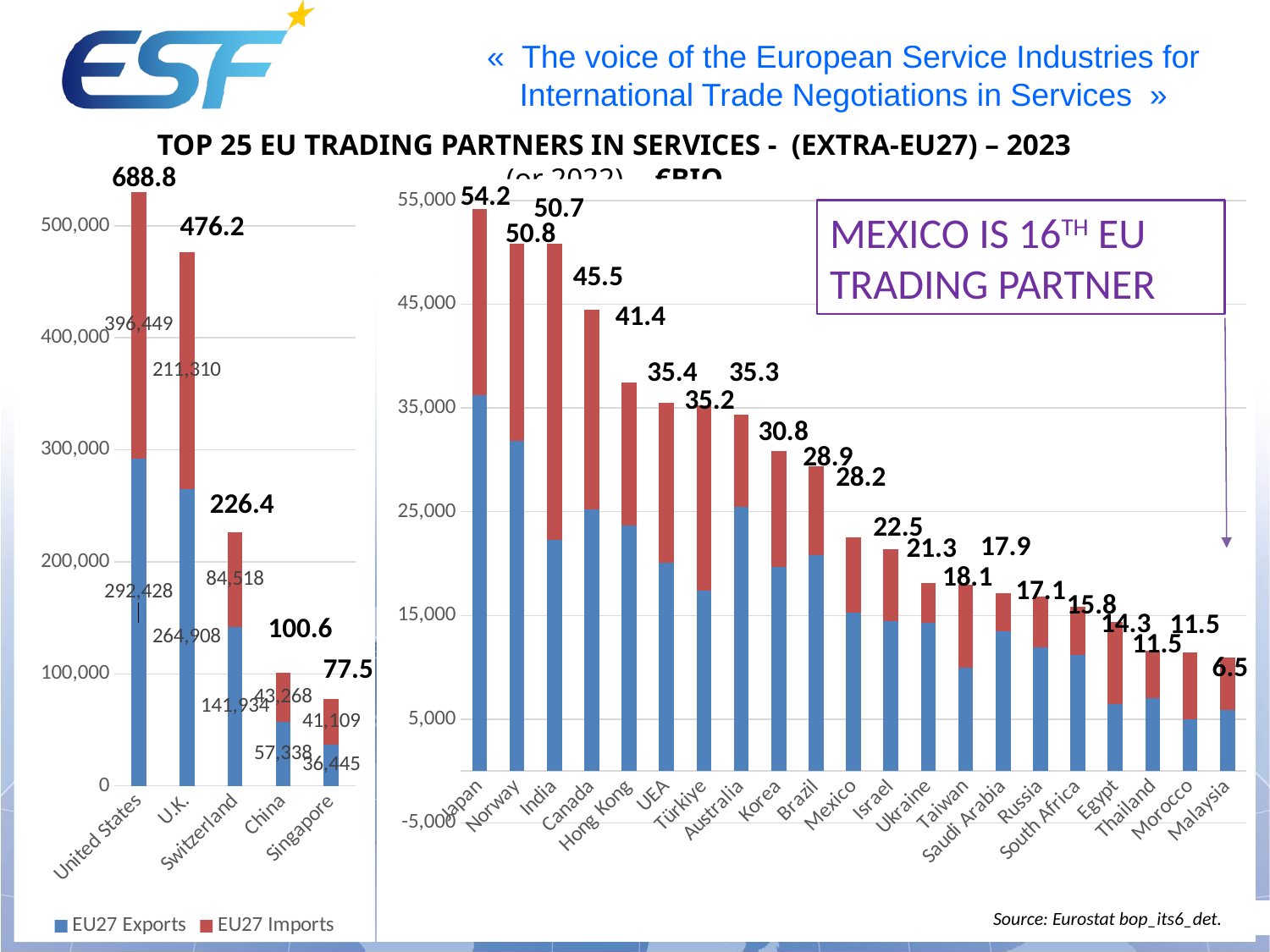
On the right chart, which trading partner has the lowest total? Malaysia According to the text box on the slide, what rank is Mexico among EU trading partners? 16th On the left chart, what is the total value labelled above the United States bar? 688.8 On the left chart, what is the total value labelled above the Singapore bar? 77.5 On the left chart, what is the EU27 Exports value for the United Kingdom? 264,908 On the left chart, for the U.K., which is larger: EU27 Exports or EU27 Imports? EU27 Exports On the left chart, what is the EU27 Imports value for the United States? 396,449 What kind of chart is the right chart? Stacked bar chart On the right chart, is the value for Japan greater or less than 45,000? greater On the left chart, which trading partner has the highest total? United States How many series does the legend of the left chart list? 2 On the left chart, what is the difference between EU27 Imports and EU27 Exports for the United States? 104,021